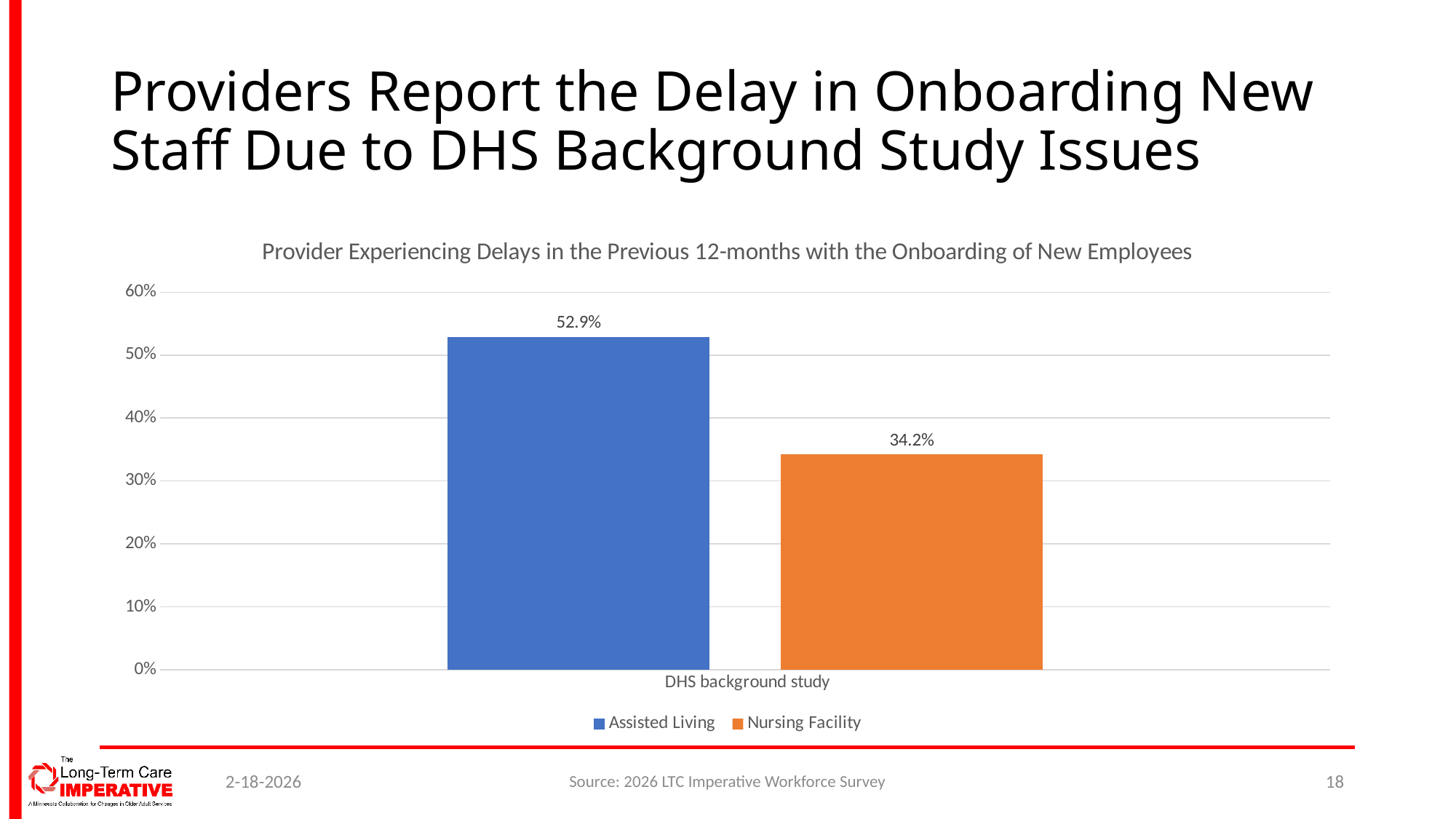
How many categories are shown on the x axis? 1 Is the value for Nursing Facility greater or less than 40%? less What kind of chart is shown on the slide? bar chart What is the title of the chart? Provider Experiencing Delays in the Previous 12-months with the Onboarding of New Employees Which series has the lower value for DHS background study? Nursing Facility Which series has the higher value for DHS background study? Assisted Living What is the value for Assisted Living for DHS background study? 52.9% What is the value for Nursing Facility for DHS background study? 34.2% What is the difference between the Assisted Living and Nursing Facility values? 18.7% Is the value for Assisted Living larger or smaller than the value for Nursing Facility? larger Is the value for Assisted Living greater or less than 50%? greater How many series does the legend list? 2